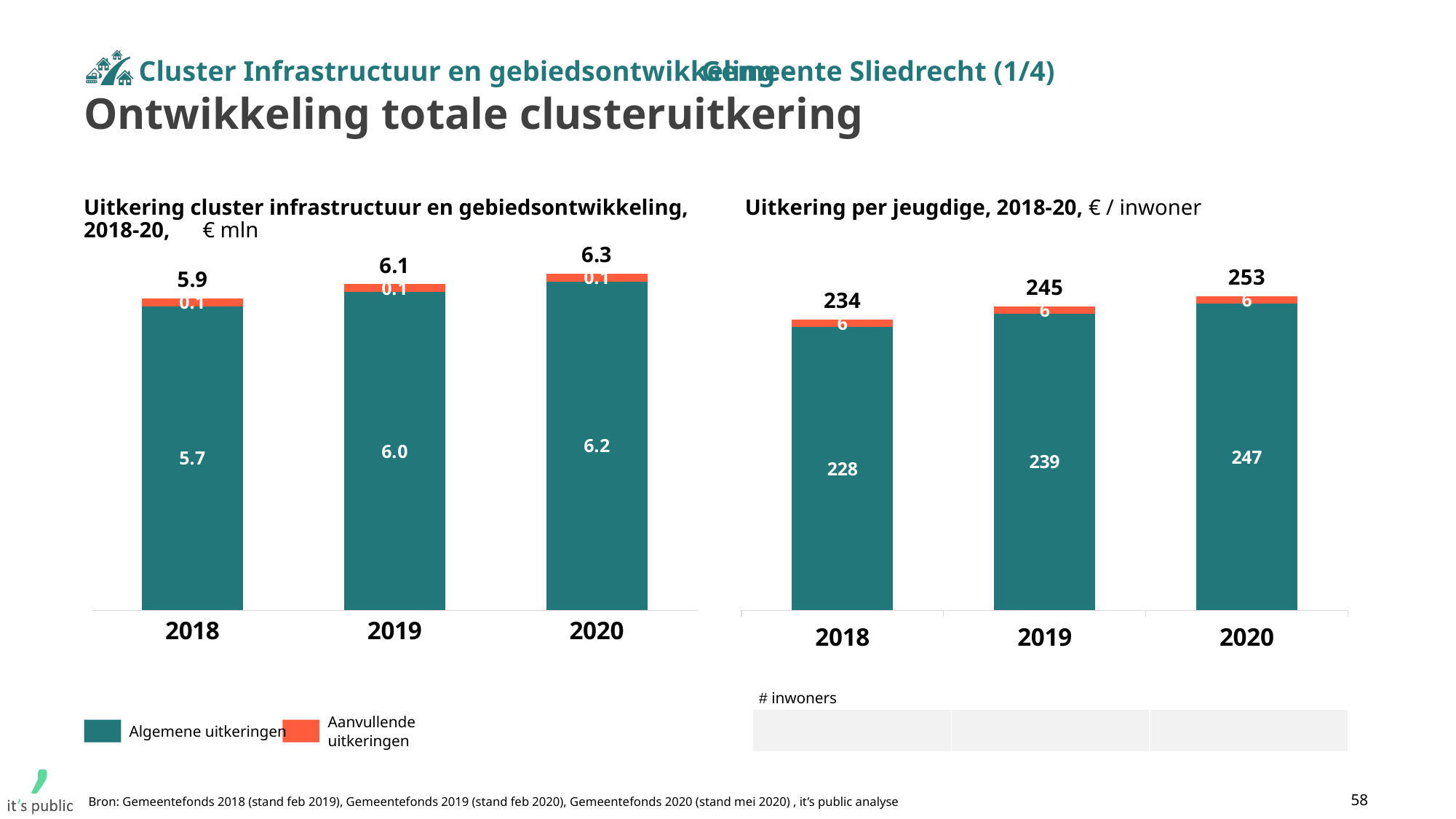
In the left chart (Uitkering cluster infrastructuur en gebiedsontwikkeling), what is the difference between the 2020 total and the 2018 total? 0.4 In the right chart (Uitkering per jeugdige), what is the value of Algemene uitkeringen for 2020? 247 In the right chart (Uitkering per jeugdige), what is the value of Aanvullende uitkeringen for 2018? 6 In the left chart (Uitkering cluster infrastructuur en gebiedsontwikkeling), what is the total shown above the 2020 bar? 6.3 How many series does the legend list for the charts on this slide? 2 In the left chart (Uitkering cluster infrastructuur en gebiedsontwikkeling), what is the value of Algemene uitkeringen for 2019? 6.0 In the right chart (Uitkering per jeugdige), which year has the highest total? 2020 In the left chart (Uitkering cluster infrastructuur en gebiedsontwikkeling), what is the value of Aanvullende uitkeringen for 2018? 0.1 In the left chart (Uitkering cluster infrastructuur en gebiedsontwikkeling), which year has the lowest total? 2018 In the right chart (Uitkering per jeugdige), what is the total for 2019? 245 In the right chart (Uitkering per jeugdige), what is the difference between the Algemene uitkeringen values for 2019 and 2018? 11 In the left chart (Uitkering cluster infrastructuur en gebiedsontwikkeling), do the totals rise or fall from 2018 to 2020? rise